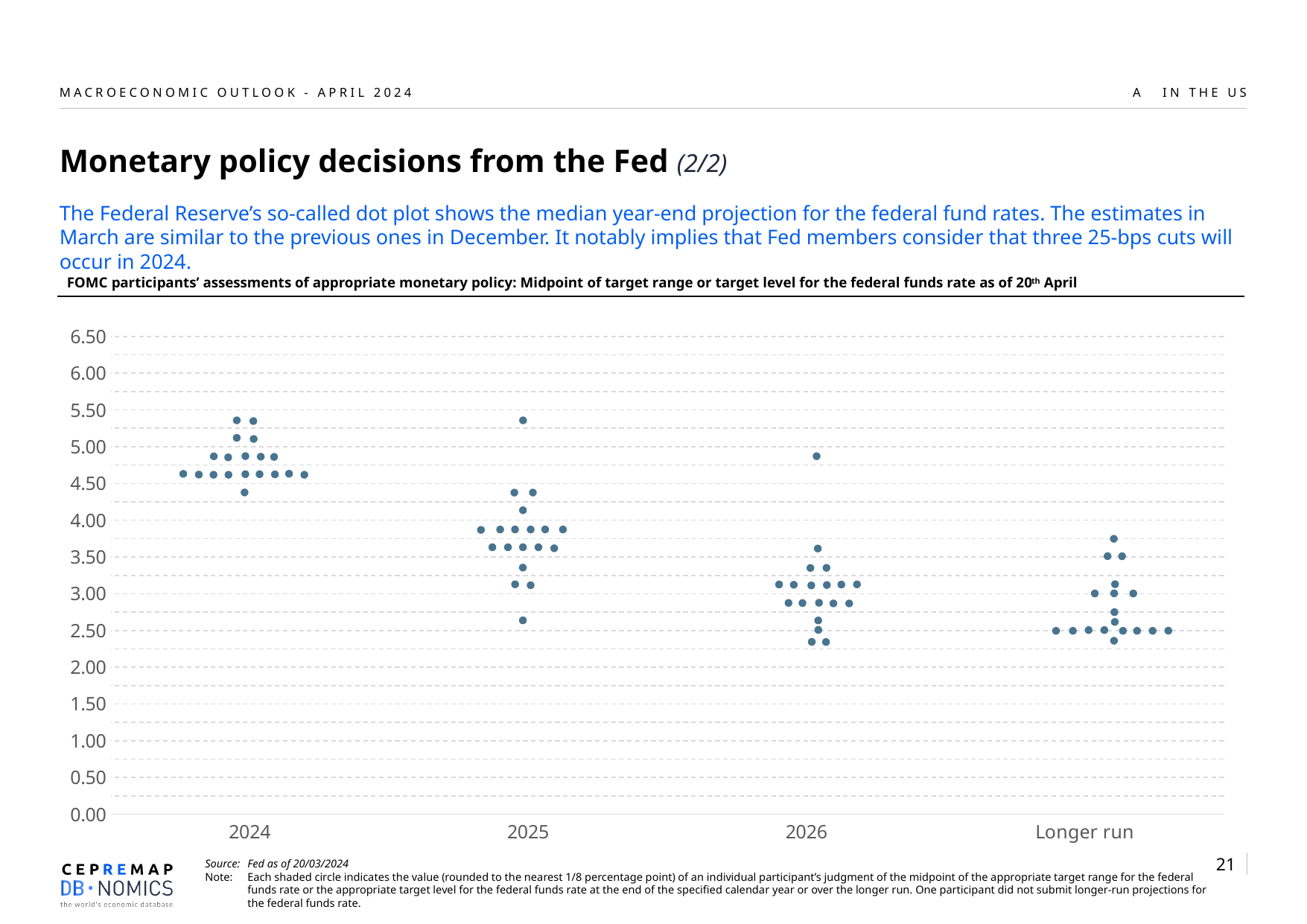
What is the highest value labelled on the y axis of the chart? 6.50 What kind of chart is shown on the slide? Dot plot (scatter chart) Is the highest dot for 2026 greater or less than 4.50? greater Is the lowest dot for 2024 greater or less than 4.00? greater Are all the dots for Longer run greater or less than 4.00? less Which is higher, the highest dot for 2024 or the highest dot for Longer run? 2024 How many categories are shown on the x axis of the chart? 4 Do the dot clusters generally rise or fall moving from 2024 to Longer run along the x axis? fall What are the four categories on the x axis of the chart? 2024, 2025, 2026, Longer run Which category has its dots clustered at the highest level overall? 2024